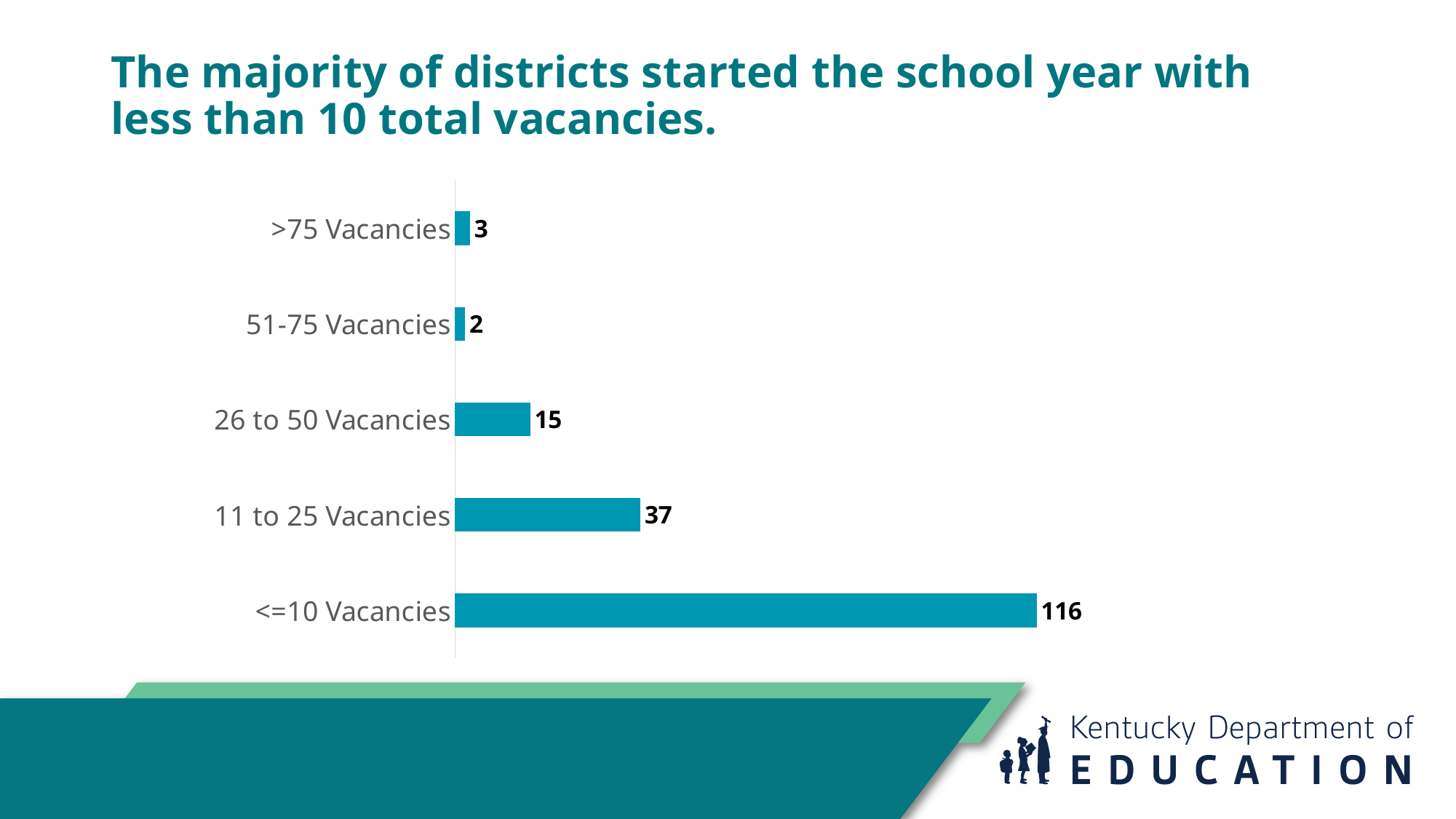
What is the title of the slide? The majority of districts started the school year with less than 10 total vacancies. What is the value for the 26 to 50 Vacancies category? 15 Which category has the lowest value? 51-75 Vacancies Which is larger, the value for 11 to 25 Vacancies or the value for 26 to 50 Vacancies? 11 to 25 Vacancies What is the value for the 11 to 25 Vacancies category? 37 What is the difference between the values for <=10 Vacancies and 11 to 25 Vacancies? 79 How many districts started the school year with <=10 vacancies? 116 What is the difference between the values for 26 to 50 Vacancies and >75 Vacancies? 12 What kind of chart is shown on the slide? Bar chart How many categories are shown in the chart? 5 Which category has the highest value? <=10 Vacancies What is the value for the >75 Vacancies category? 3